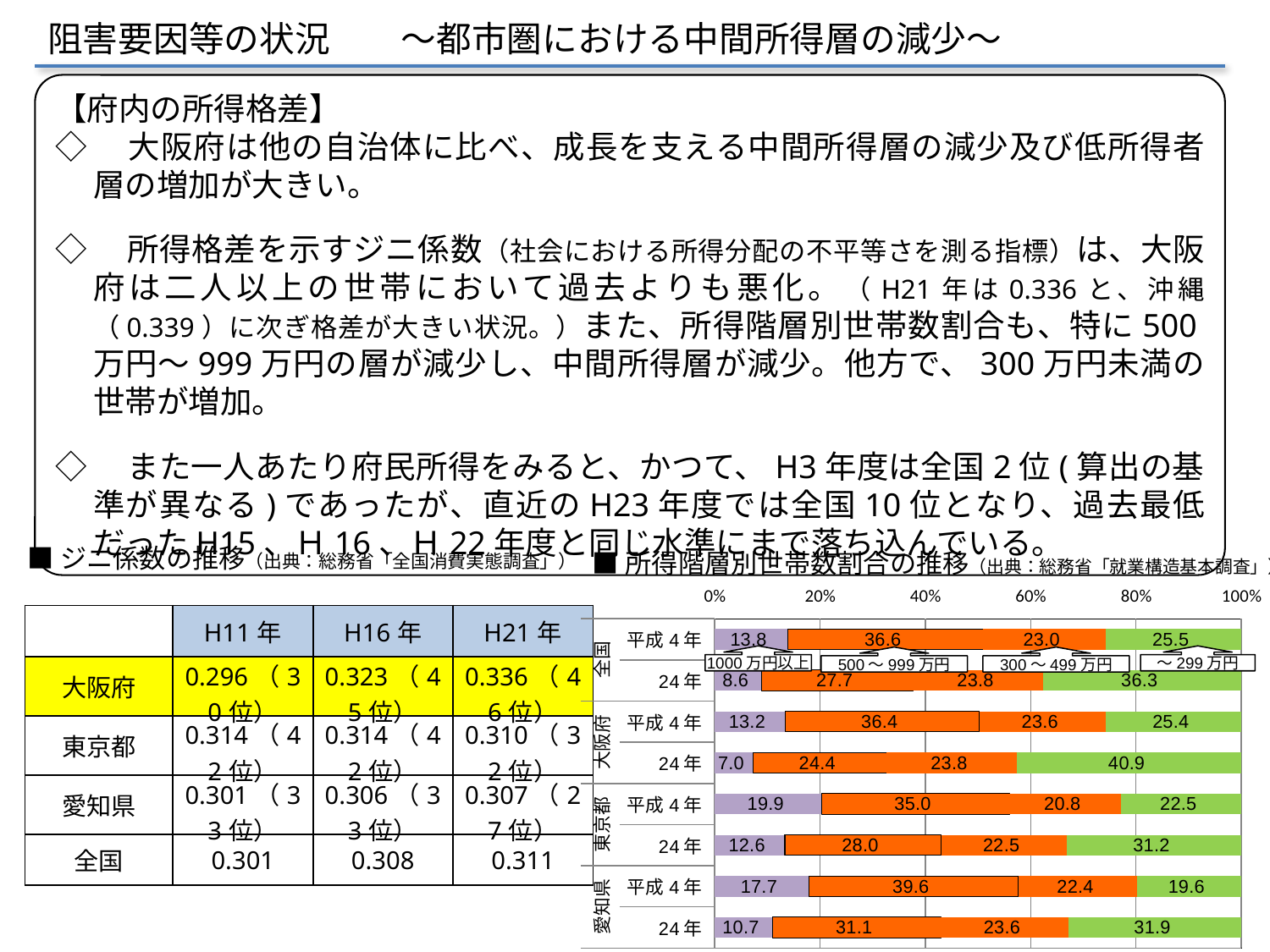
In the 所得階層別世帯数割合の推移 chart, how many series does the legend list? 4 In the 所得階層別世帯数割合の推移 chart, which bar has the smallest 1000万円以上 segment? 大阪府 24年 In the 所得階層別世帯数割合の推移 chart, what is the value of the ～299万円 segment for 大阪府 24年? 40.9 In the 所得階層別世帯数割合の推移 chart, what is the value of the 1000万円以上 segment for 東京都 平成4年? 19.9 In the 所得階層別世帯数割合の推移 chart, what colour represents the ～299万円 series? Green In the 所得階層別世帯数割合の推移 chart, what is the difference between the 500～999万円 values for 大阪府 平成4年 and 大阪府 24年? 12.0 In the 所得階層別世帯数割合の推移 chart, what is the value of the 500～999万円 segment for 愛知県 平成4年? 39.6 In the 所得階層別世帯数割合の推移 chart, which is larger: the 1000万円以上 value for 東京都 24年 or for 愛知県 24年? 東京都 24年 What kind of chart is the 所得階層別世帯数割合の推移 chart? Stacked bar chart In the 所得階層別世帯数割合の推移 chart, what is the value of the 300～499万円 segment for 全国 24年? 23.8 In the 所得階層別世帯数割合の推移 chart, how many bars are plotted? 8 In the 所得階層別世帯数割合の推移 chart, which bar has the largest ～299万円 segment? 大阪府 24年